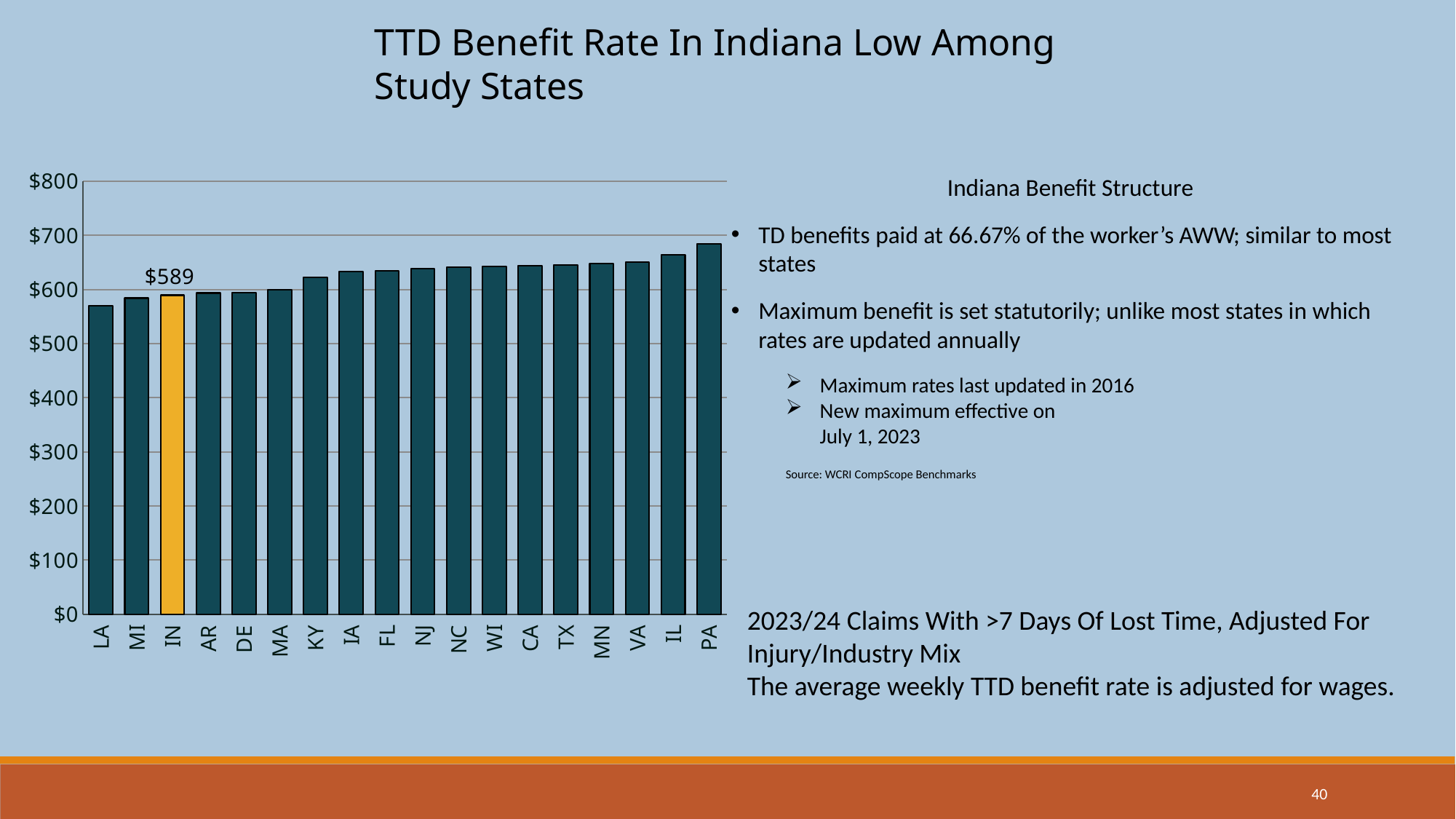
Which has a larger value, LA or PA? PA How many states are shown on the x axis of the chart? 18 Is the value for PA greater or less than $600? greater What kind of chart is shown on the slide? Bar chart Is the value for KY greater or less than $600? greater Is the value for LA greater or less than $600? less What is the TTD benefit rate shown for IN? $589 Do the bar values rise or fall from left to right across the x axis? Rise Which state's bar is highlighted in a different colour (orange) from the others? IN Which state has the highest bar in the chart? PA Which state has the lowest bar in the chart? LA